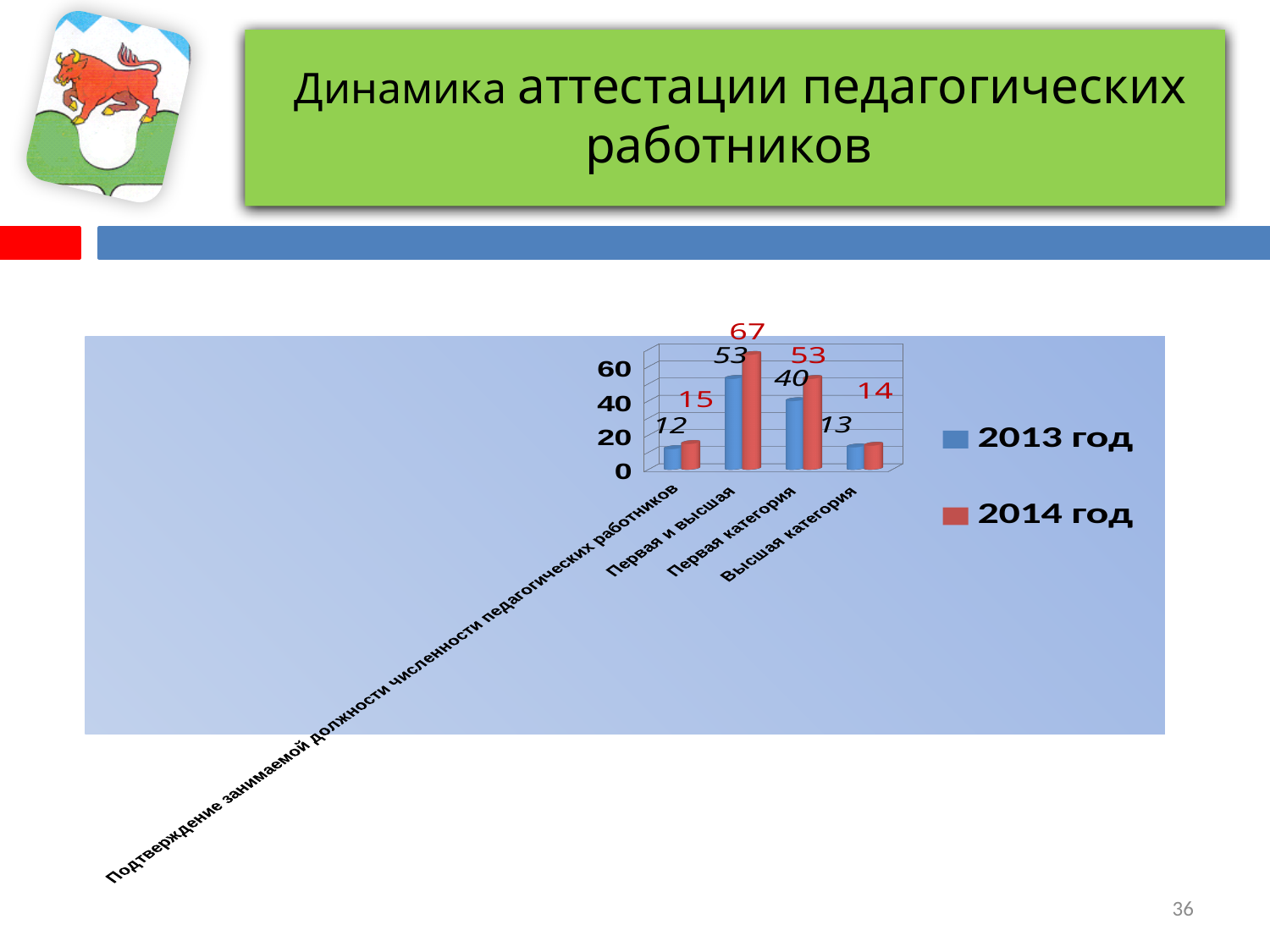
Which is larger for "Высшая категория": the 2013 год value or the 2014 год value? 2014 год What is the difference between the 2014 год and 2013 год values for "Первая и высшая"? 14 What is the value for "Первая категория" in the 2013 год series? 40 What kind of chart is shown on the slide? Bar chart What is the value for "Первая и высшая" in the 2014 год series? 67 How many categories are shown on the x axis of the chart? 4 How many series does the legend list? 2 Which category has the lowest value in the 2013 год series? Подтверждение занимаемой должности численности педагогических работников What is the value for "Высшая категория" in the 2014 год series? 14 What is the difference between the 2014 год and 2013 год values for "Первая категория"? 13 What is the value for "Подтверждение занимаемой должности численности педагогических работников" in the 2013 год series? 12 Which category has the highest value in the 2014 год series? Первая и высшая